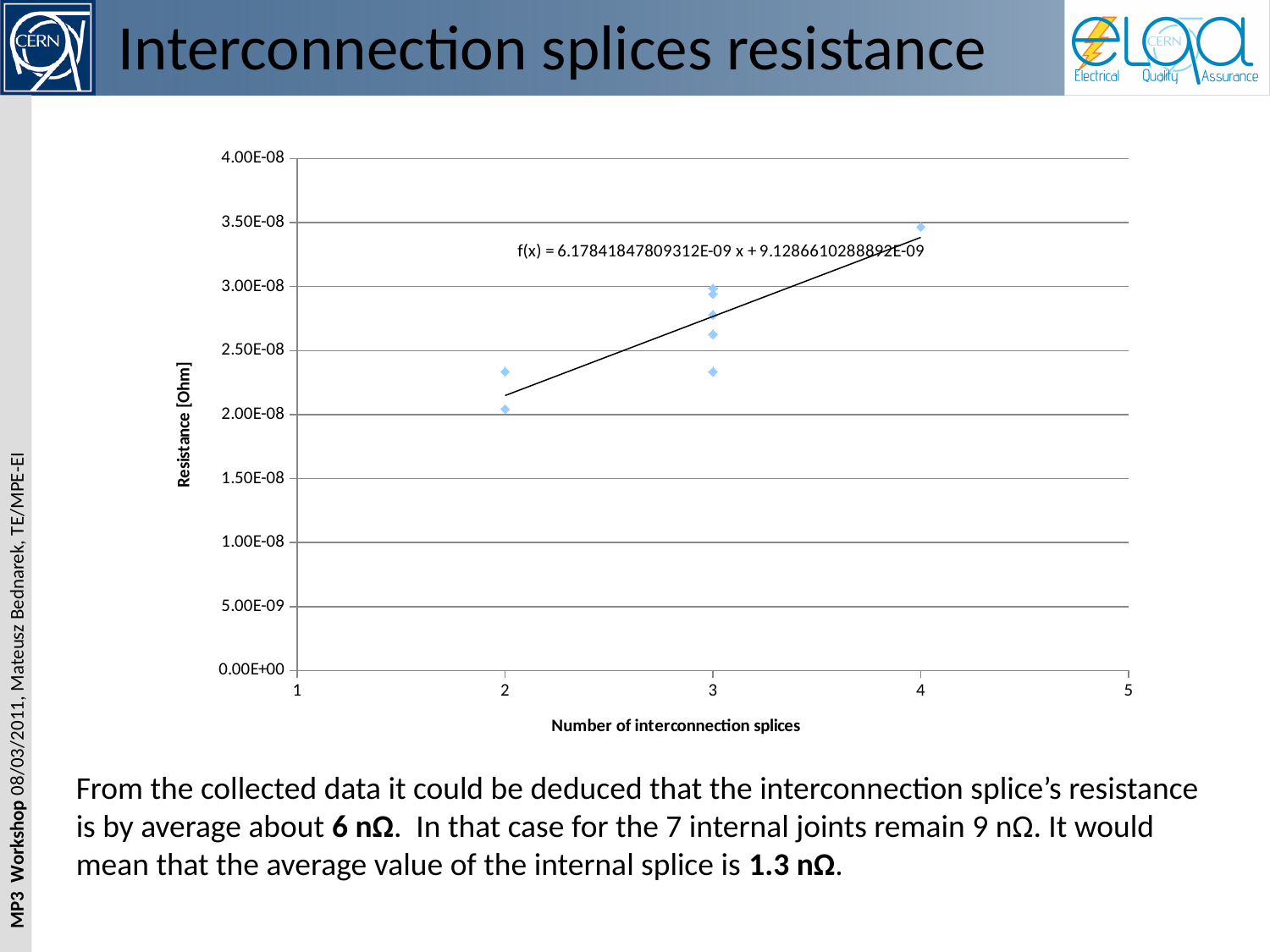
At which number of interconnection splices is the lowest resistance value plotted? 2 Does the resistance tend to rise or fall as the number of interconnection splices increases? Rise How many data points are plotted at 4 interconnection splices? 1 At which number of interconnection splices is the highest resistance value plotted? 4 Is the lowest resistance value plotted at 3 interconnection splices greater or less than 2.00E-08? greater What is the title of the y axis of the chart? Resistance [Ohm] Are the resistance values plotted at 2 interconnection splices greater or less than 2.50E-08? less What is the title of the x axis of the chart? Number of interconnection splices What kind of chart is shown on the slide? Scatter chart How many data points are plotted at 2 interconnection splices? 2 Is the resistance value plotted at 4 interconnection splices greater or less than 3.00E-08? greater